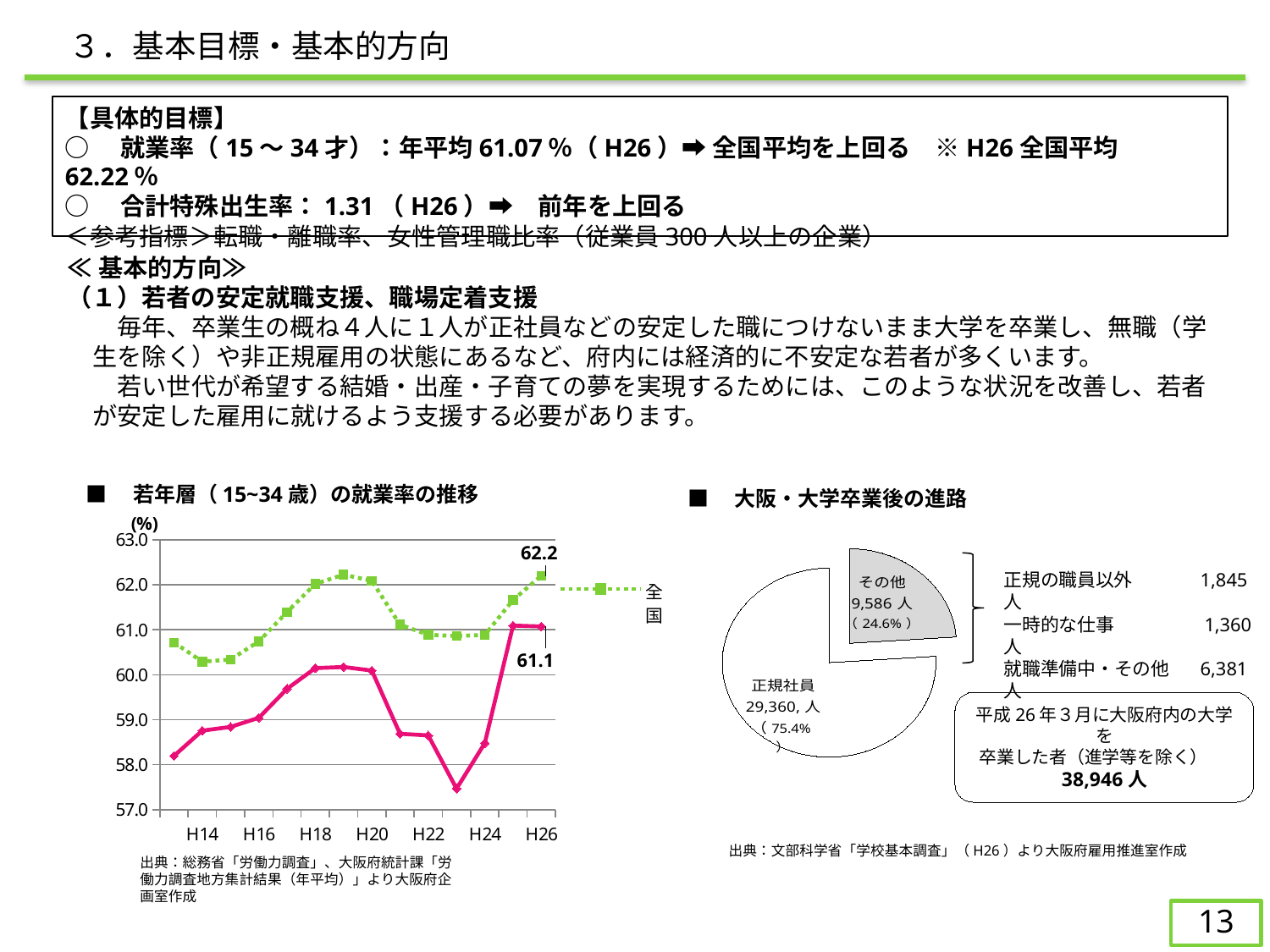
In the 大阪・大学卒業後の進路 chart, which slice is the largest? 正規社員 In the 若年層（15~34歳）の就業率の推移 chart, at H26 which is higher, the 全国 line or the solid pink line? 全国 What kind of chart is the 若年層（15~34歳）の就業率の推移 chart? line chart In the 大阪・大学卒業後の進路 chart, how many people are in the その他 slice? 9,586 人 In the 大阪・大学卒業後の進路 chart, what share of the pie is 正規社員? 75.4% In the 若年層（15~34歳）の就業率の推移 chart, what is the 全国 value at H26? 62.2 In the 若年層（15~34歳）の就業率の推移 chart, is the 全国 value at H14 greater or less than 60.0? greater In the 大阪・大学卒業後の進路 chart, how many slices does the pie have? 2 In the 若年層（15~34歳）の就業率の推移 chart, what value does the solid pink line show at H26? 61.1 In the 若年層（15~34歳）の就業率の推移 chart, what is the difference between the 全国 value and the solid pink line value at H26? 1.1 What kind of chart is the 大阪・大学卒業後の進路 chart? pie chart In the 若年層（15~34歳）の就業率の推移 chart, what unit is shown on the vertical axis? (%)